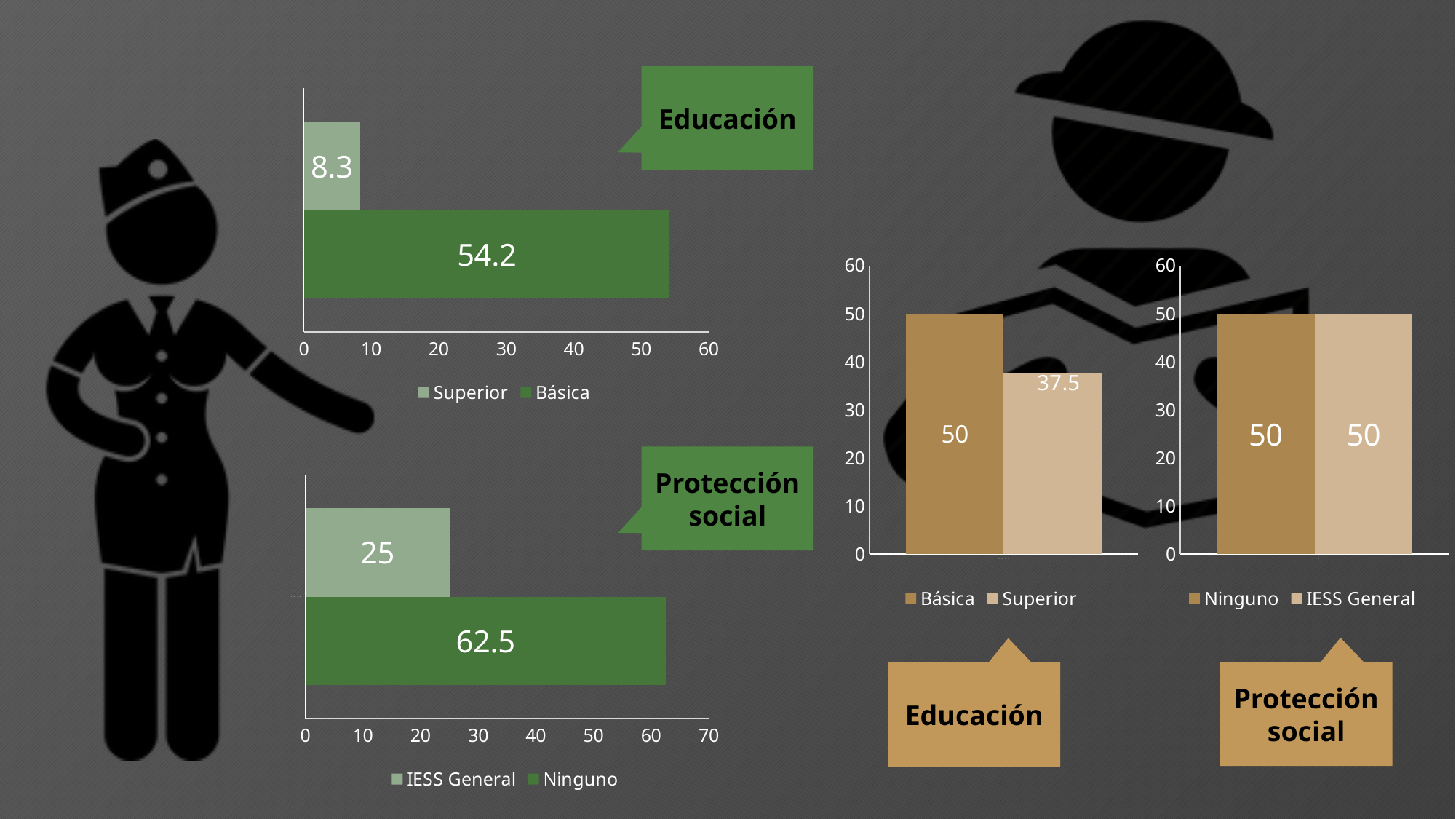
What kind of chart is the green Educación chart on the left? Bar chart In the green Protección social bar chart on the left, what is the value for Ninguno? 62.5 In the green Educación bar chart on the left, what is the value for Superior? 8.3 How many series does the legend of the brown Protección social chart on the right list? 2 In the brown Educación bar chart on the right, what is the difference between Básica and Superior? 12.5 In the brown Educación bar chart on the right, which series is highest? Básica In the green Educación bar chart on the left, what is the difference between Básica and Superior? 45.9 In the brown Educación bar chart on the right, what is the value for Superior? 37.5 In the brown Protección social bar chart on the right, what is the value for IESS General? 50 In the green Protección social bar chart on the left, which series has the larger value, IESS General or Ninguno? Ninguno In the green Protección social bar chart on the left, what is the value for IESS General? 25 In the green Educación bar chart on the left, what is the value for Básica? 54.2